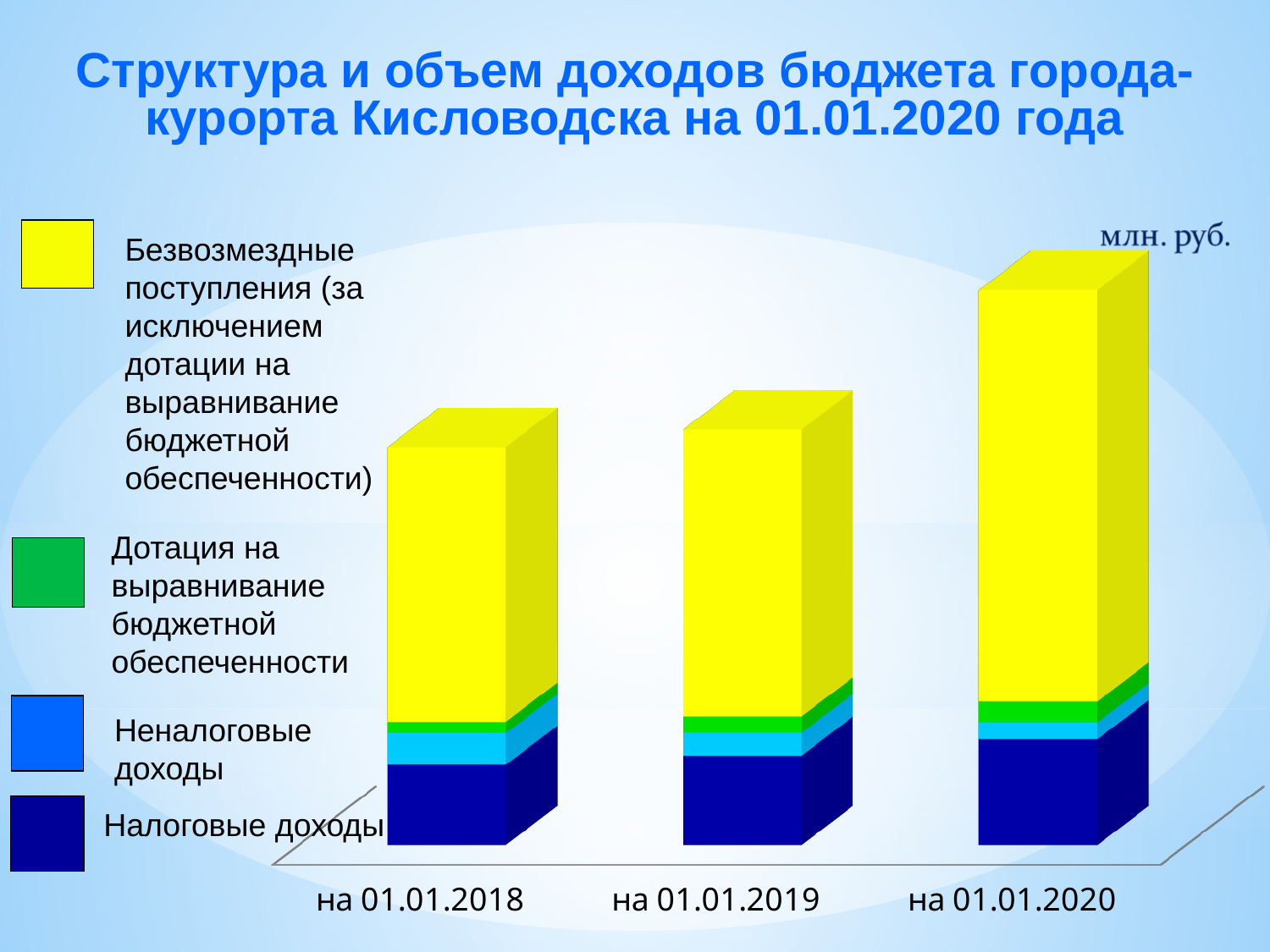
Which series is shown at the bottom of each stacked bar? Налоговые доходы How many series does the legend of the chart list? 4 Which is larger, the total bar for на 01.01.2020 or the total bar for на 01.01.2018? на 01.01.2020 What unit is indicated in the top right corner of the chart? млн. руб. How many dates (categories) are shown along the x axis of the chart? 3 Which date has the tallest total bar in the chart? на 01.01.2020 Which is larger, the total bar for на 01.01.2020 or the total bar for на 01.01.2019? на 01.01.2020 Which series forms the largest segment of the bar for на 01.01.2020? Безвозмездные поступления (за исключением дотации на выравнивание бюджетной обеспеченности) What kind of chart is shown on the slide? Stacked bar chart Do the total bar heights rise or fall from на 01.01.2018 to на 01.01.2020? Rise